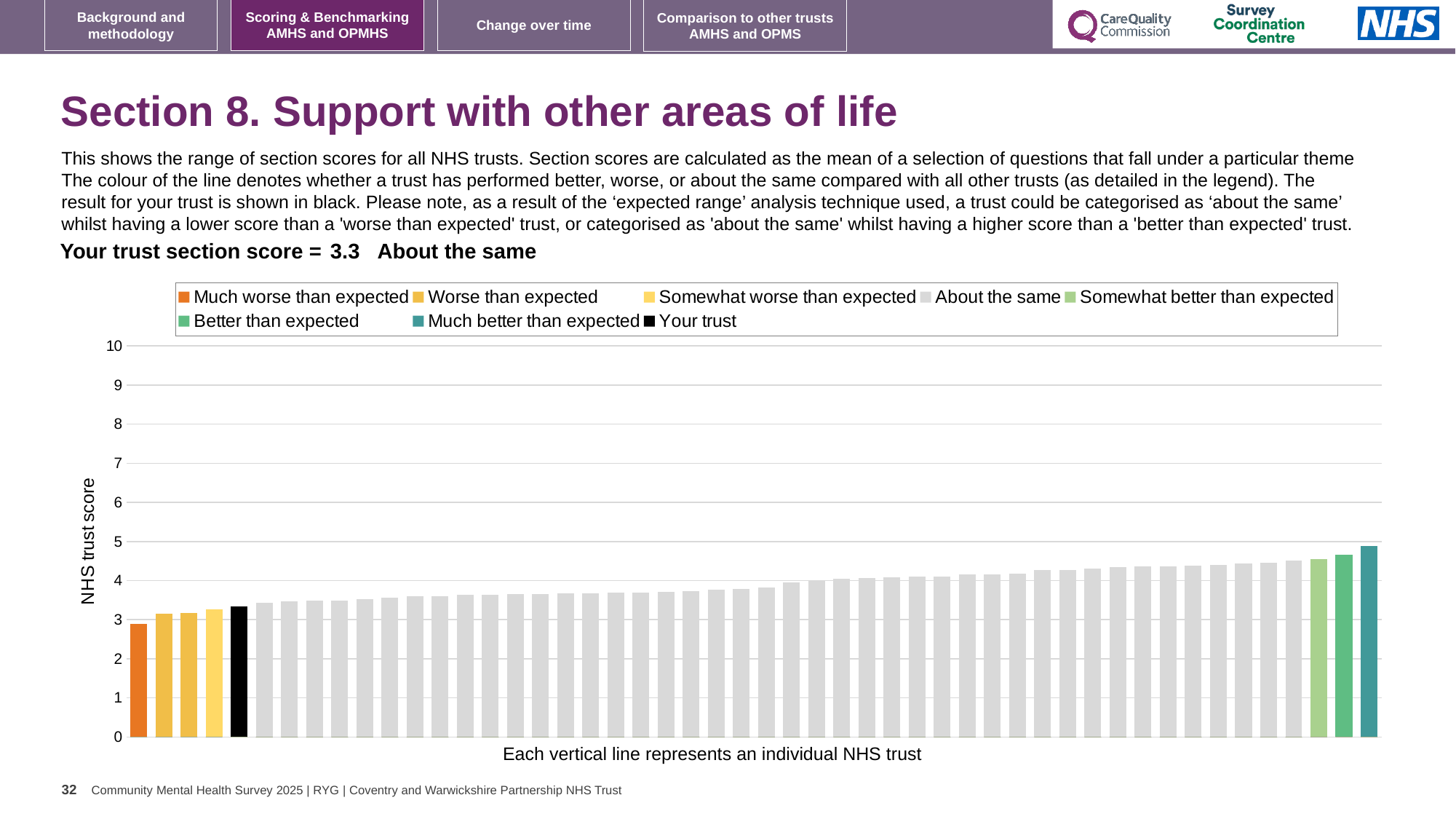
What is the section score for your trust (the black bar)? 3.3 How many bars are coloured as 'Much worse than expected'? 1 How many series does the legend list? 8 Is the value of the tallest bar (Much better than expected) greater or less than 4? greater Do the bar values rise or fall from left to right along the x axis? rise Is the value of the shortest bar (Much worse than expected) greater or less than 4? less Is the value for your trust (the black bar) greater or less than 4? less Which legend category does the tallest bar belong to? Much better than expected What colour represents 'Your trust' in the legend? black What kind of chart is shown on the slide? bar chart What is the label of the y axis? NHS trust score Which legend category does the shortest bar belong to? Much worse than expected